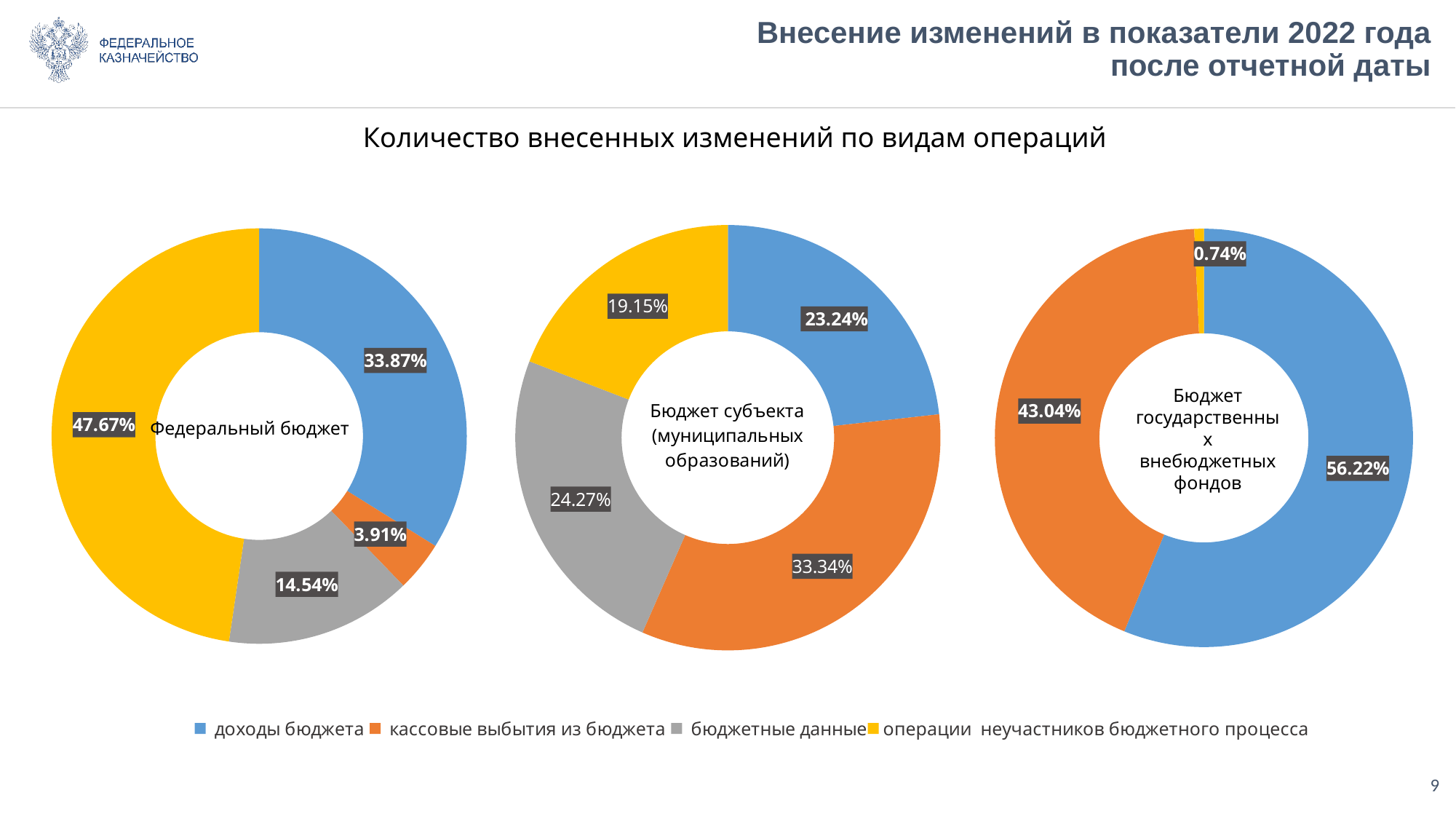
In the 'Бюджет субъекта (муниципальных образований)' chart, which category has the largest share? кассовые выбытия из бюджета In the 'Федеральный бюджет' chart, what share is labelled for 'операции неучастников бюджетного процесса'? 47.67% In the 'Федеральный бюджет' chart, which category has the smallest share? кассовые выбытия из бюджета In the 'Бюджет государственных внебюджетных фондов' chart, what share is labelled for 'доходы бюджета'? 56.22% What kind of chart is used for 'Федеральный бюджет'? Pie (donut) chart In the 'Бюджет субъекта (муниципальных образований)' chart, what share is labelled for 'бюджетные данные'? 24.27% In the 'Бюджет государственных внебюджетных фондов' chart, which category has the smallest labelled share? операции неучастников бюджетного процесса In the 'Бюджет субъекта (муниципальных образований)' chart, which is larger: the share for 'доходы бюджета' or for 'операции неучастников бюджетного процесса'? доходы бюджета In the 'Федеральный бюджет' chart, what is the difference between the shares for 'доходы бюджета' and 'бюджетные данные'? 19.33% In the 'Федеральный бюджет' chart, what share is labelled for 'кассовые выбытия из бюджета'? 3.91% How many series does the legend list? 4 What is the title shown above the three charts? Количество внесенных изменений по видам операций